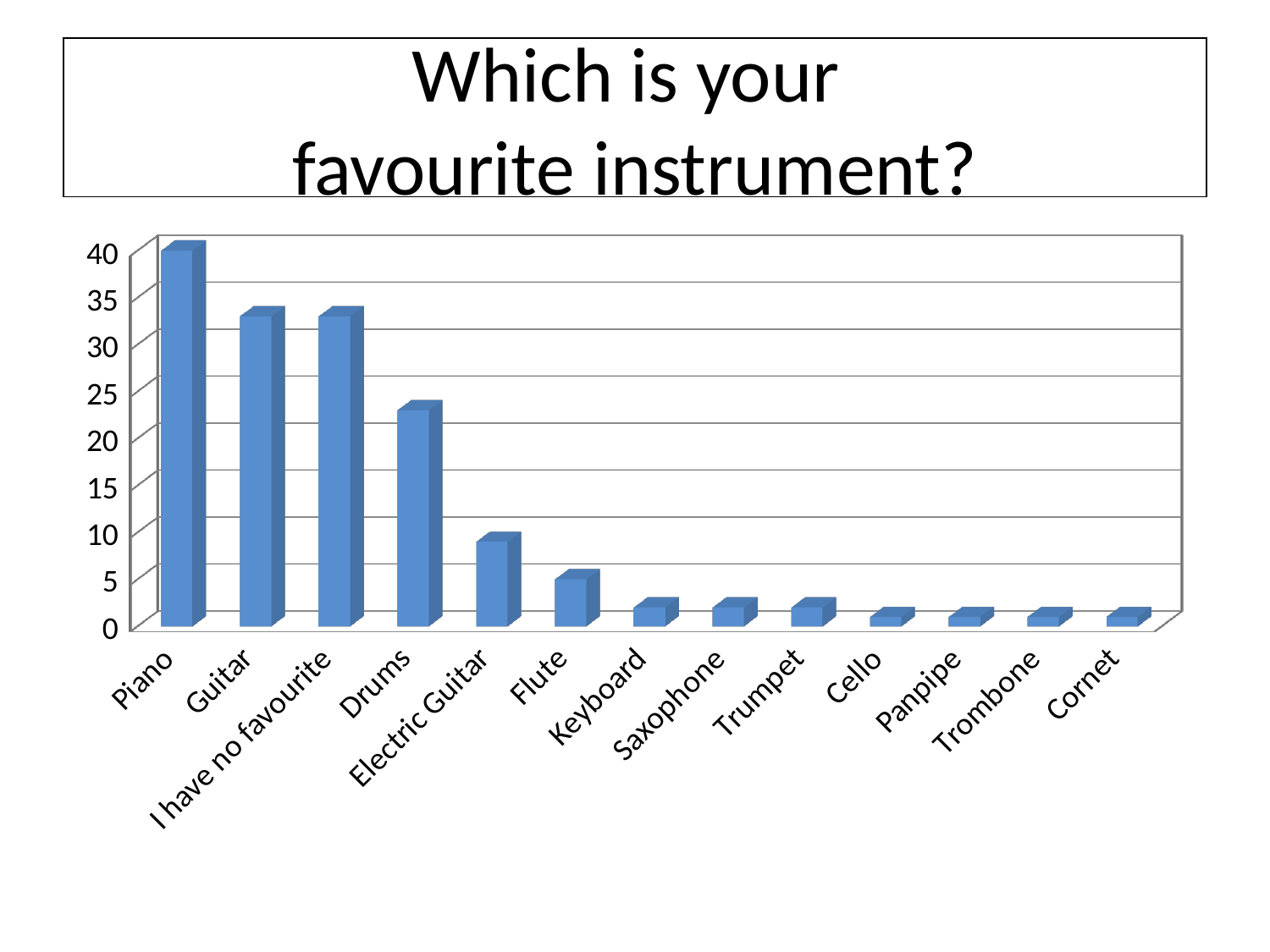
What is the title of the chart on the slide? Which is your favourite instrument? What kind of chart is shown on the slide? bar chart Which has a larger value, Drums or Flute? Drums Is the value for Keyboard greater or less than 5? less Is the value for Flute greater or less than 10? less Do the values generally rise or fall moving from left to right along the x axis? fall Is the value for Guitar greater or less than 30? greater Which has a larger value, Piano or Drums? Piano How many categories are shown on the x axis? 13 Which instrument category has the highest value? Piano